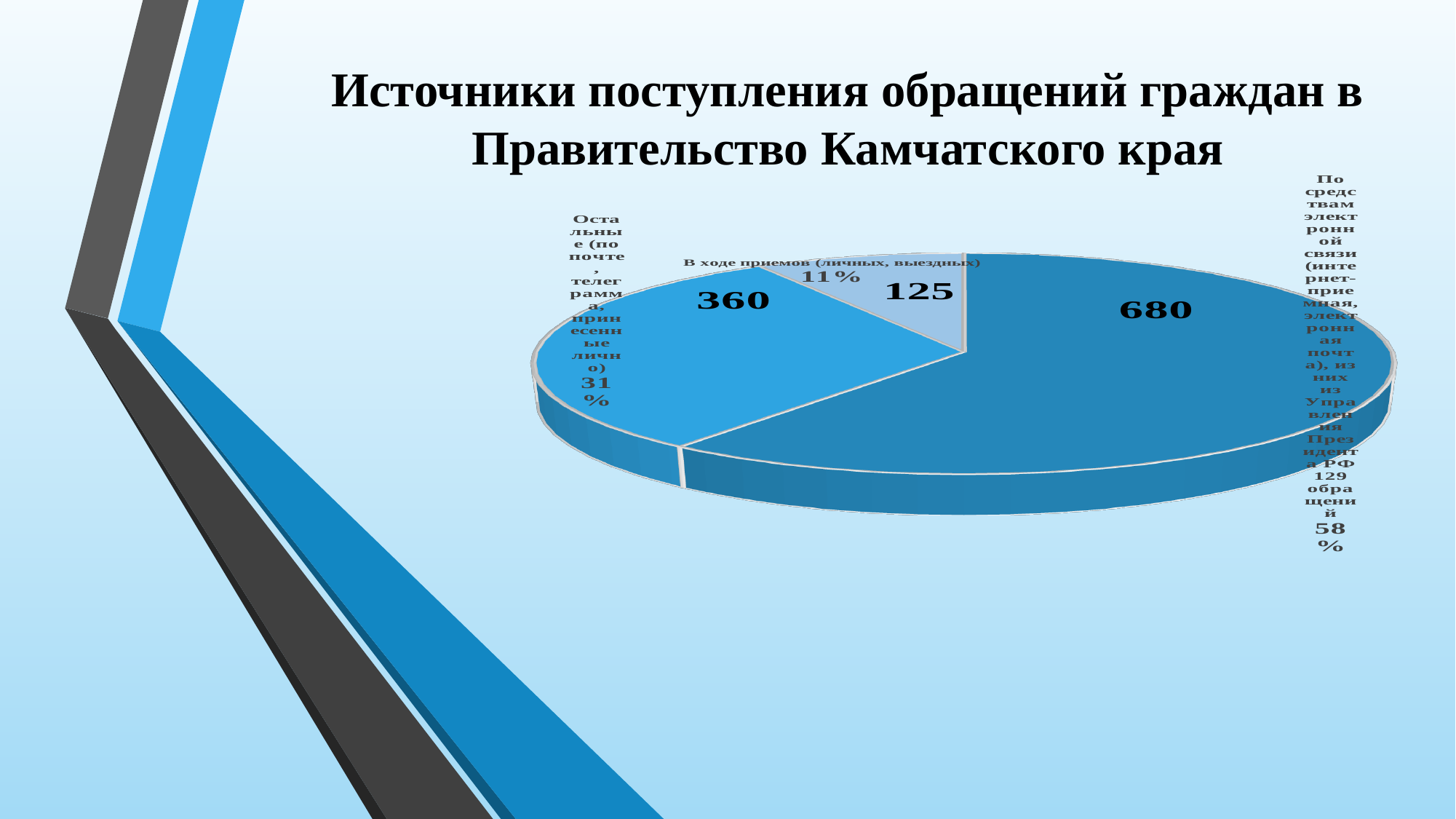
What percentage share is shown for the slice 'Остальные (по почте, телеграмма, принесенные лично)'? 31% What percentage share is shown for the slice 'По средствам электронной связи (интернет-приемная, электронная почта)'? 58% Which slice has the largest value? По средствам электронной связи (интернет-приемная, электронная почта) What is the value for the slice 'В ходе приемов (личных, выездных)'? 125 What percentage share is shown for the slice 'В ходе приемов (личных, выездных)'? 11% How many slices does the pie chart have? 3 What is the title of the slide containing the chart? Источники поступления обращений граждан в Правительство Камчатского края Which slice has the smallest value? В ходе приемов (личных, выездных) What is the difference between the value for electronic communication (680) and the value for 'Остальные' (360)? 320 What is the value for the slice 'По средствам электронной связи (интернет-приемная, электронная почта)'? 680 What kind of chart is shown on the slide? Pie chart What is the value for the slice 'Остальные (по почте, телеграмма, принесенные лично)'? 360